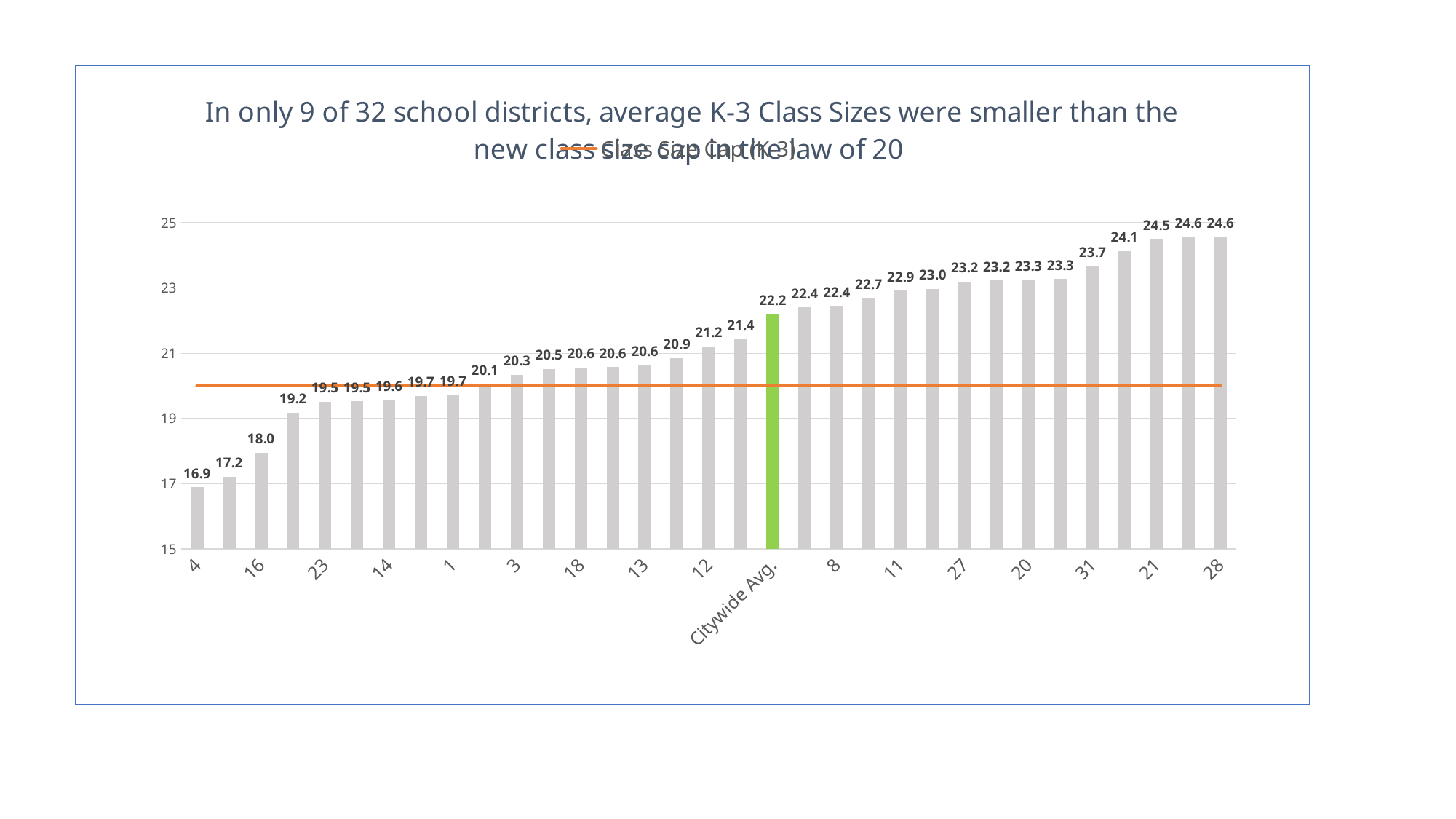
Which has a larger average K-3 class size, district 31 or district 11? 31 What is the average K-3 class size for district 28? 24.6 What is the value shown for the Citywide Avg. bar? 22.2 Which labeled district has the lowest average K-3 class size? 4 What kind of chart is shown on the slide? combination bar and line chart What is the value shown for district 12? 21.2 What colour is the Citywide Avg. bar? green Do the bar values rise or fall from left to right along the x axis? rise What is the difference between the Citywide Avg. and the value for district 1? 2.5 What is the difference between the values for district 21 and district 4? 7.6 Is the value for district 16 greater or less than 19? less What is the average K-3 class size for district 4? 16.9